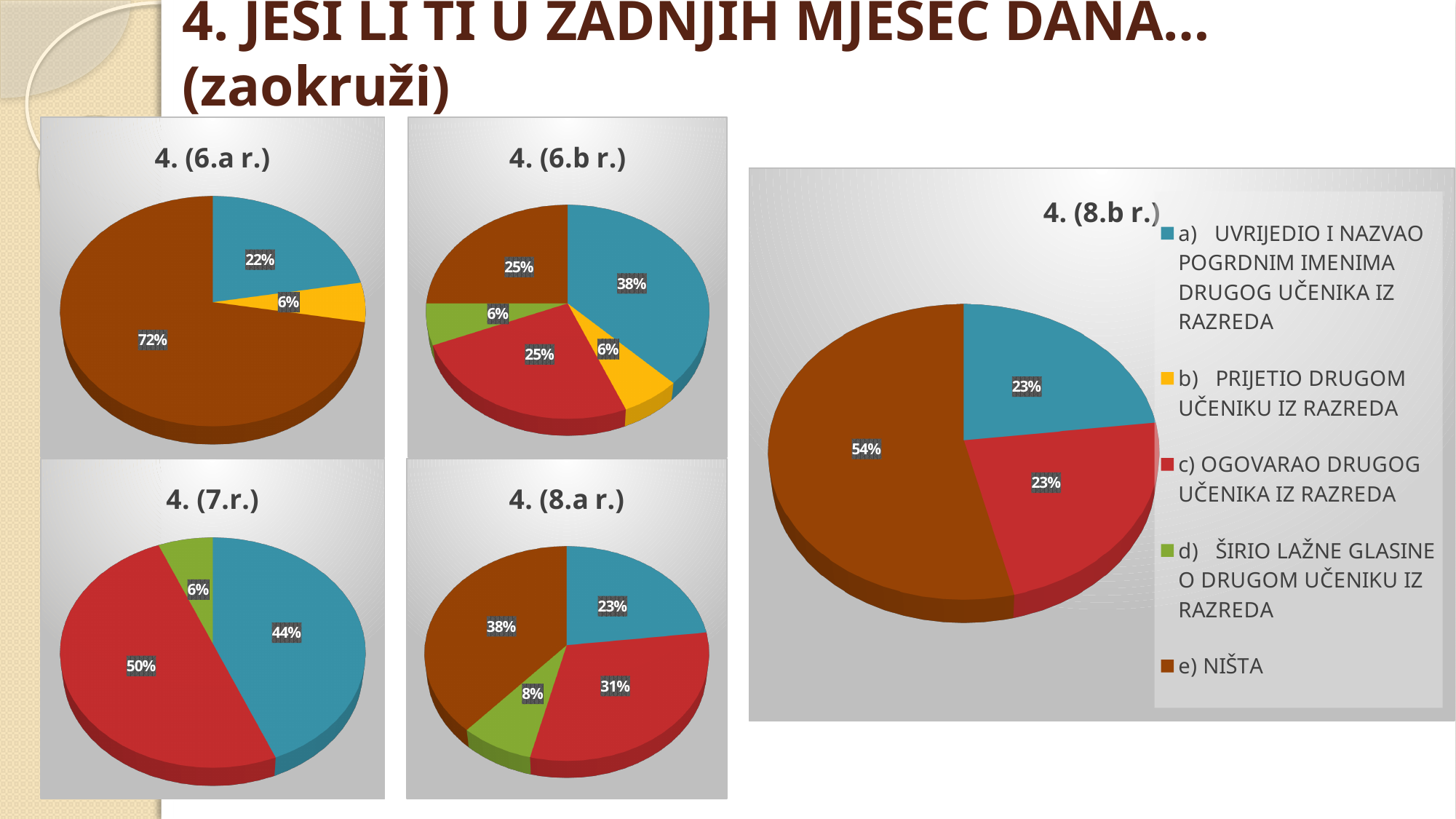
In the chart titled "4. (7.r.)", which slice is the largest? c) OGOVARAO DRUGOG UČENIKA IZ RAZREDA (50%) In the chart titled "4. (8.a r.)", which slice is the smallest? d) ŠIRIO LAŽNE GLASINE O DRUGOM UČENIKU IZ RAZREDA (8%) In the chart titled "4. (6.a r.)", what percentage is shown for the brown slice (e) NIŠTA)? 72% In the chart titled "4. (8.b r.)", what share of the pie does the e) NIŠTA slice take? 54% In the chart titled "4. (8.b r.)", what is the difference in percentage points between the e) NIŠTA slice and the a) UVRIJEDIO slice? 31 In the chart titled "4. (8.a r.)", which is larger: the c) OGOVARAO slice or the a) UVRIJEDIO slice? c) OGOVARAO DRUGOG UČENIKA IZ RAZREDA (31%) How many slices does the chart titled "4. (6.b r.)" have? 5 In the chart titled "4. (6.b r.)", what percentage is shown for the blue slice (a) UVRIJEDIO I NAZVAO POGRDNIM IMENIMA DRUGOG UČENIKA IZ RAZREDA)? 38% In the chart titled "4. (7.r.)", what percentage is shown for the green slice (d) ŠIRIO LAŽNE GLASINE)? 6% How many entries does the legend next to the chart titled "4. (8.b r.)" list? 5 How many pie charts are shown on the slide? 5 What type of chart is used for "4. (7.r.)"? Pie chart